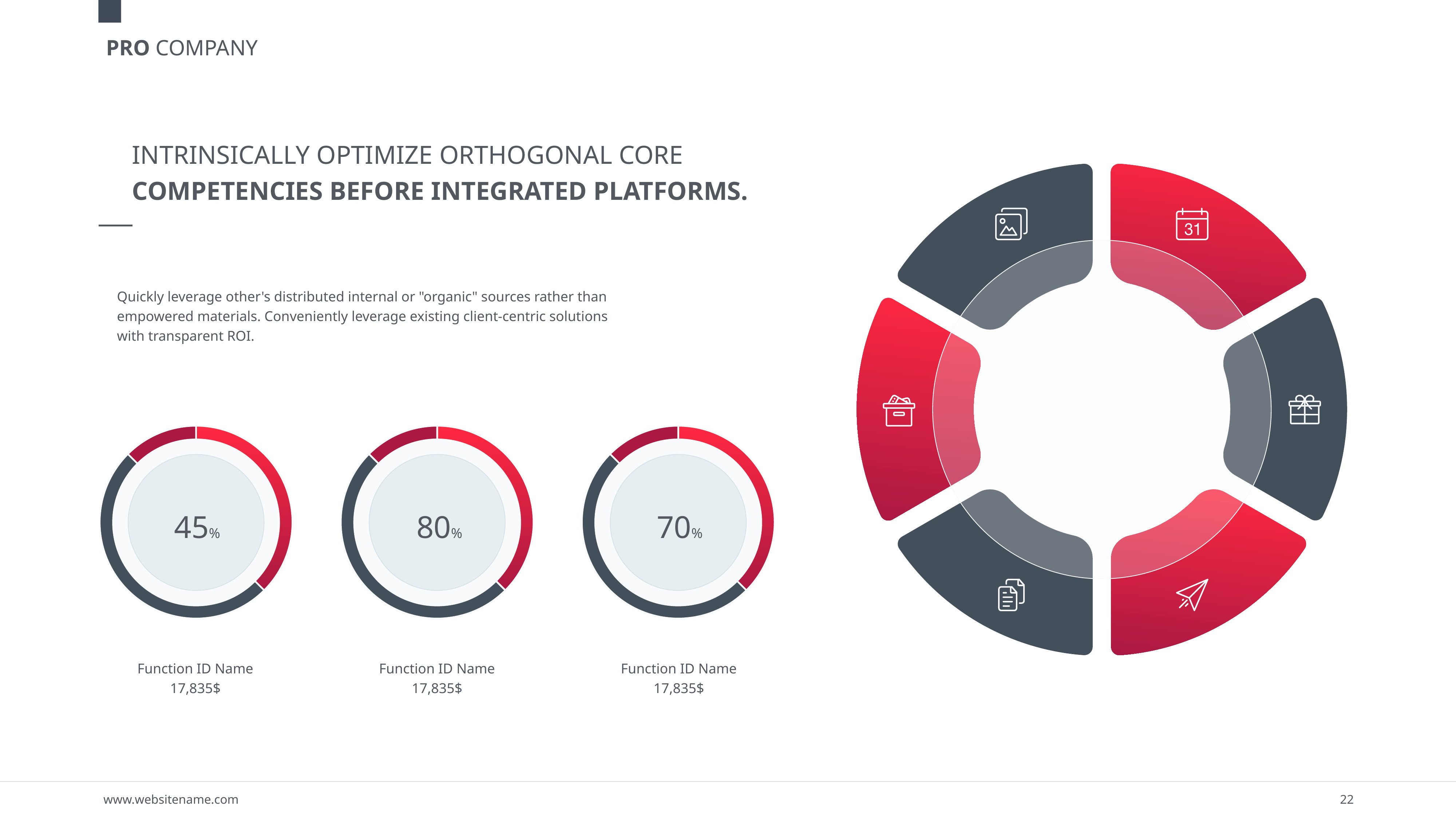
What value is shown in the middle donut chart? 80% What is the difference between the percentage in the middle donut chart and the percentage in the right donut chart? 10% What kind of chart is used to display the 45%, 80% and 70% values? Donut chart What is the difference between the percentage in the middle donut chart and the percentage in the left donut chart? 35% Which is larger, the value in the right donut chart or the value in the left donut chart? The right donut chart (70%) What value is shown in the right donut chart? 70% What dollar amount is printed below the middle donut chart? 17,835$ Which of the three donut charts shows the lowest percentage? The left one (45%) What label is printed below each of the three donut charts? Function ID Name How many donut charts are shown on the slide? 3 What value is shown in the left donut chart? 45% Which of the three donut charts shows the highest percentage? The middle one (80%)